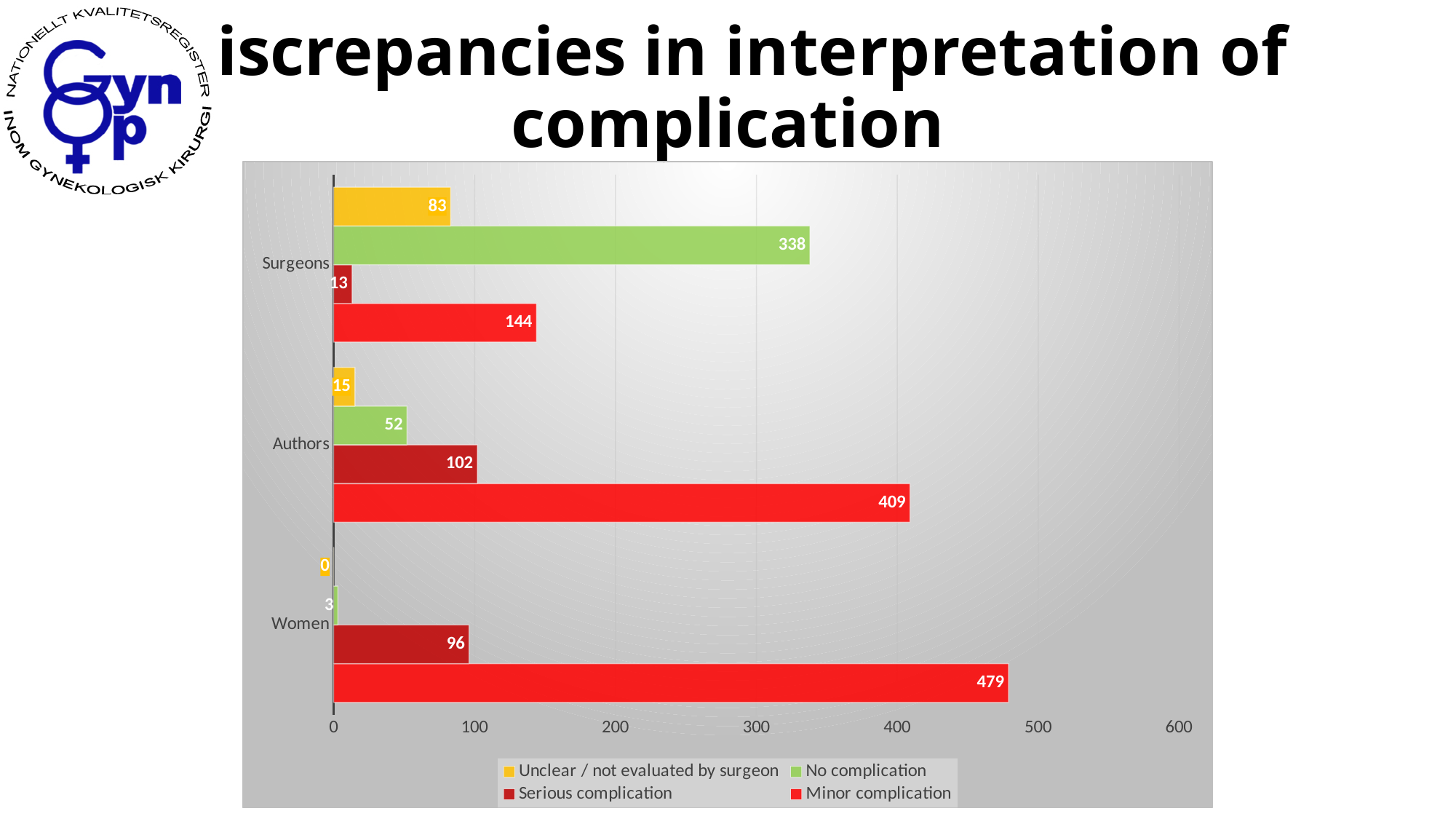
Which is larger: Serious complication for Authors or Serious complication for Women? Authors How many series does the legend list? 4 Is the value for Minor complication in the Surgeons category greater or less than 200? less How many categories are shown on the vertical axis? 3 What is the value for No complication in the Surgeons category? 338 Which category has the highest value for Minor complication? Women What is the value for Unclear / not evaluated by surgeon in the Women category? 0 Which category has the lowest value for No complication? Women What is the difference between the Minor complication values for Women and Authors? 70 What is the value for Minor complication in the Women category? 479 What is the value for Serious complication in the Authors category? 102 What kind of chart is shown on the slide? Bar chart